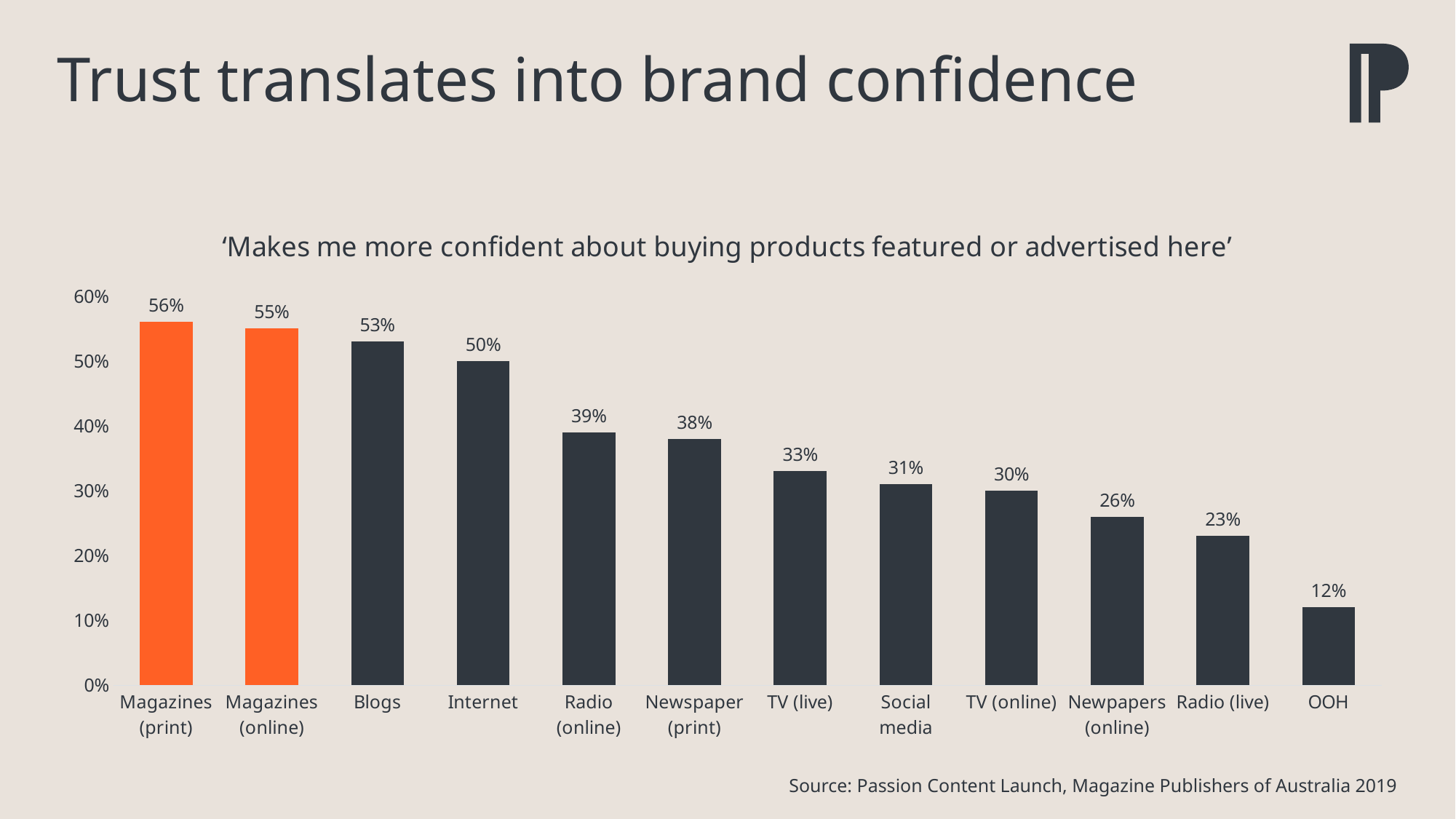
What is the difference between the values for TV (live) and OOH? 21% Which is larger, the value for Radio (online) or the value for TV (online)? Radio (online) Is the value for Newspaper (print) greater or less than 40%? less What is the value for Radio (live)? 23% How many categories are shown on the chart? 12 What kind of chart is shown on the slide? bar chart Which category has the highest value? Magazines (print) What is the value for Social media? 31% What is the value for Blogs? 53% Which two bars are highlighted in orange? Magazines (print) and Magazines (online) What is the difference between the values for Magazines (print) and Internet? 6% Which category has the lowest value? OOH